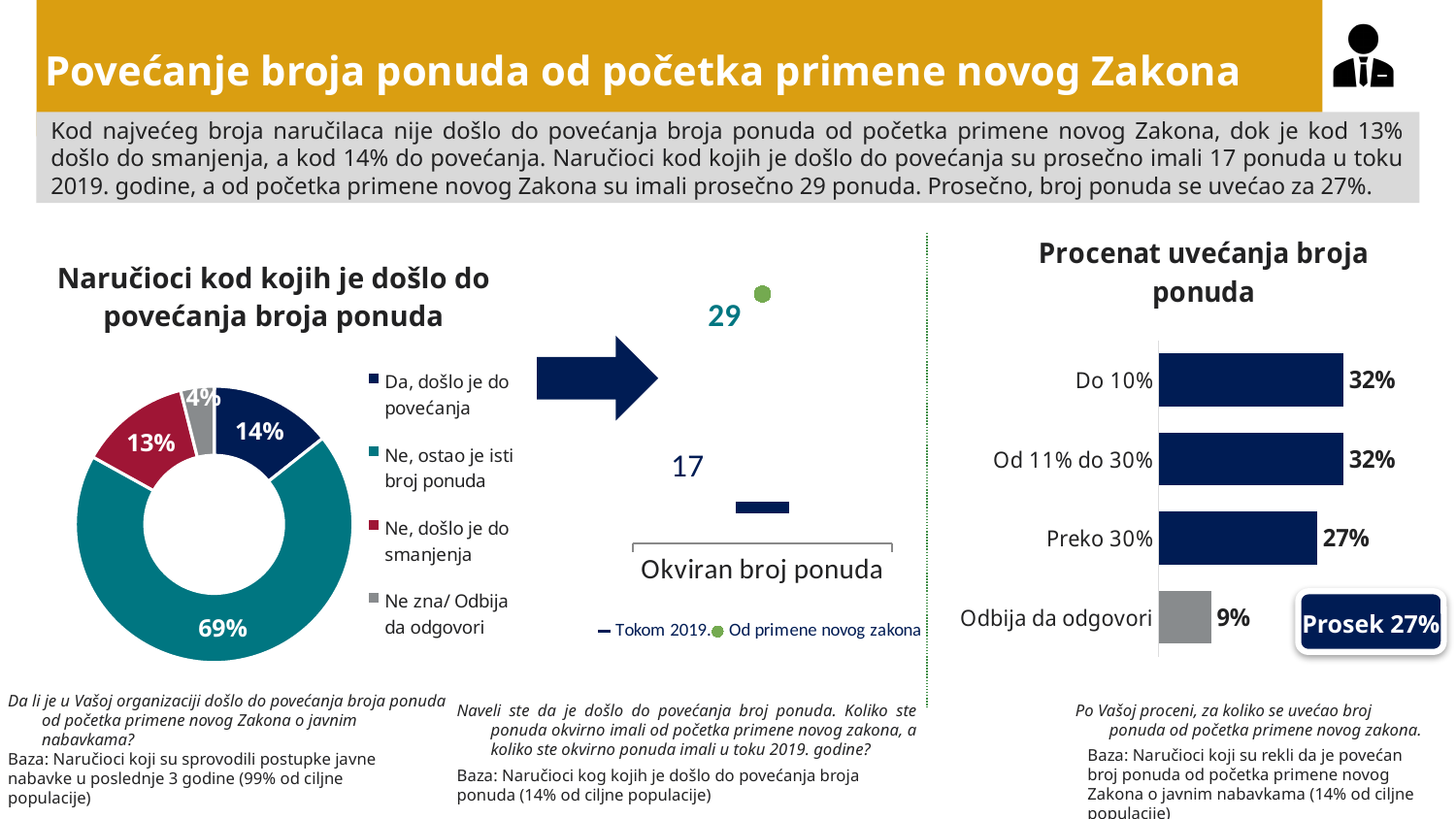
In the chart 'Naručioci kod kojih je došlo do povećanja broja ponuda', which category has the smallest share? Ne zna/ Odbija da odgovori In the chart 'Okviran broj ponuda', what is the value for 'Od primene novog zakona'? 29 In the chart 'Naručioci kod kojih je došlo do povećanja broja ponuda', how many categories does the legend list? 4 In the chart 'Procenat uvećanja broja ponuda', what is the difference between the value for 'Do 10%' and the value for 'Odbija da odgovori'? 23% In the chart 'Naručioci kod kojih je došlo do povećanja broja ponuda', what percentage is shown for 'Da, došlo je do povećanja'? 14% What kind of chart is 'Naručioci kod kojih je došlo do povećanja broja ponuda'? Pie (donut) chart In the chart 'Procenat uvećanja broja ponuda', what is the value for 'Preko 30%'? 27% What kind of chart is 'Procenat uvećanja broja ponuda'? Bar chart In the chart 'Procenat uvećanja broja ponuda', which category has the lowest value? Odbija da odgovori In the chart 'Okviran broj ponuda', what is the difference between the value for 'Od primene novog zakona' and the value for 'Tokom 2019.'? 12 In the chart 'Naručioci kod kojih je došlo do povećanja broja ponuda', what percentage is shown for 'Ne, ostao je isti broj ponuda'? 69% In the chart 'Okviran broj ponuda', what is the value for 'Tokom 2019.'? 17